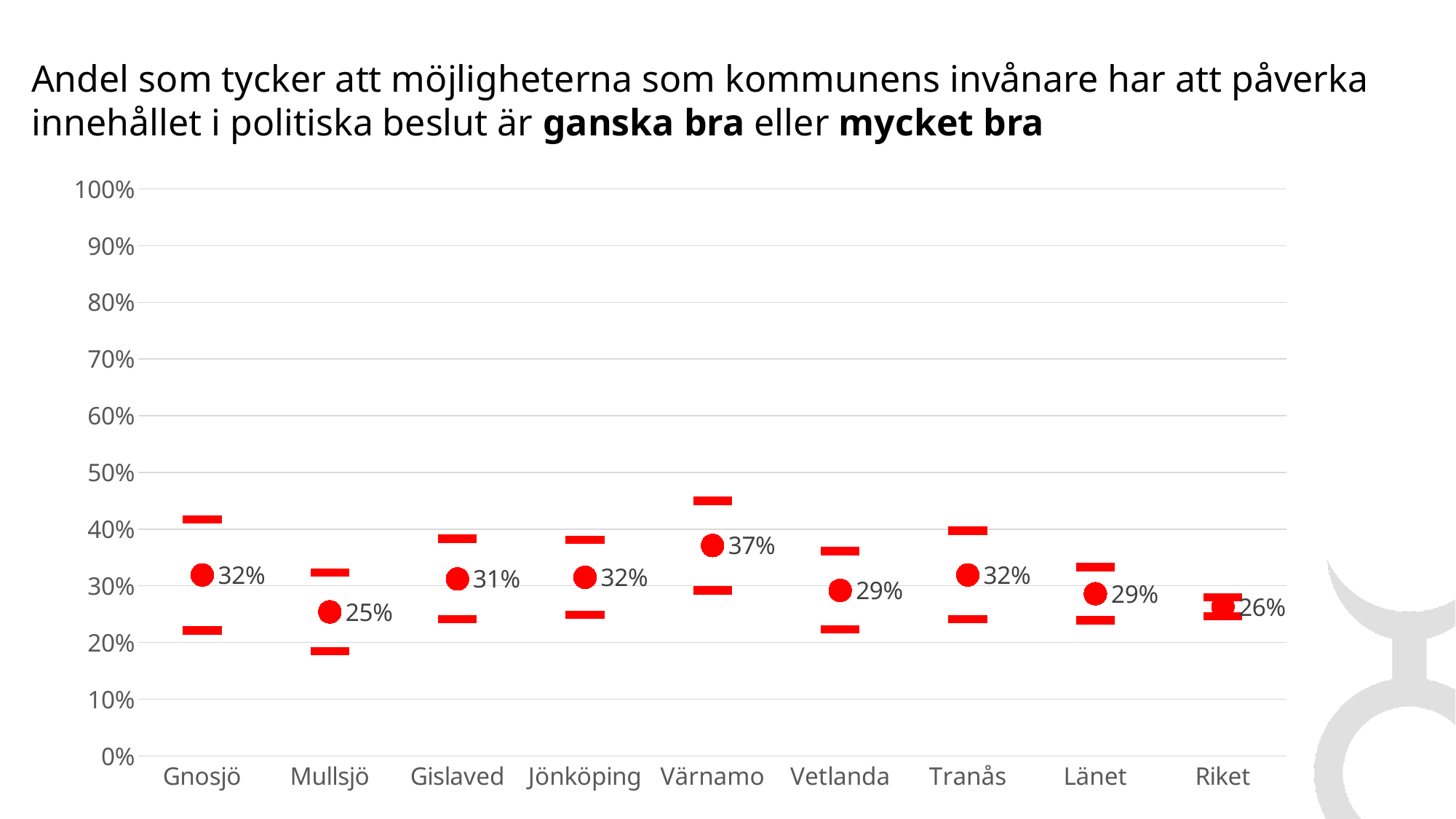
Which category has the highest value? Värnamo Which is larger, the value for Gislaved or the value for Vetlanda? Gislaved Which category has the lowest value? Mullsjö What is the value for Mullsjö? 25% How many categories are shown on the x axis? 9 Is the upper end of the interval bar for Värnamo greater or less than 40%? greater What is the value for Värnamo? 37% What is the difference between the values for Värnamo and Mullsjö? 12 percentage points What is the value for Länet? 29% What kind of chart is this? Dot plot with error bars What colour are the data points and interval bars? Red What is the value for Riket? 26%